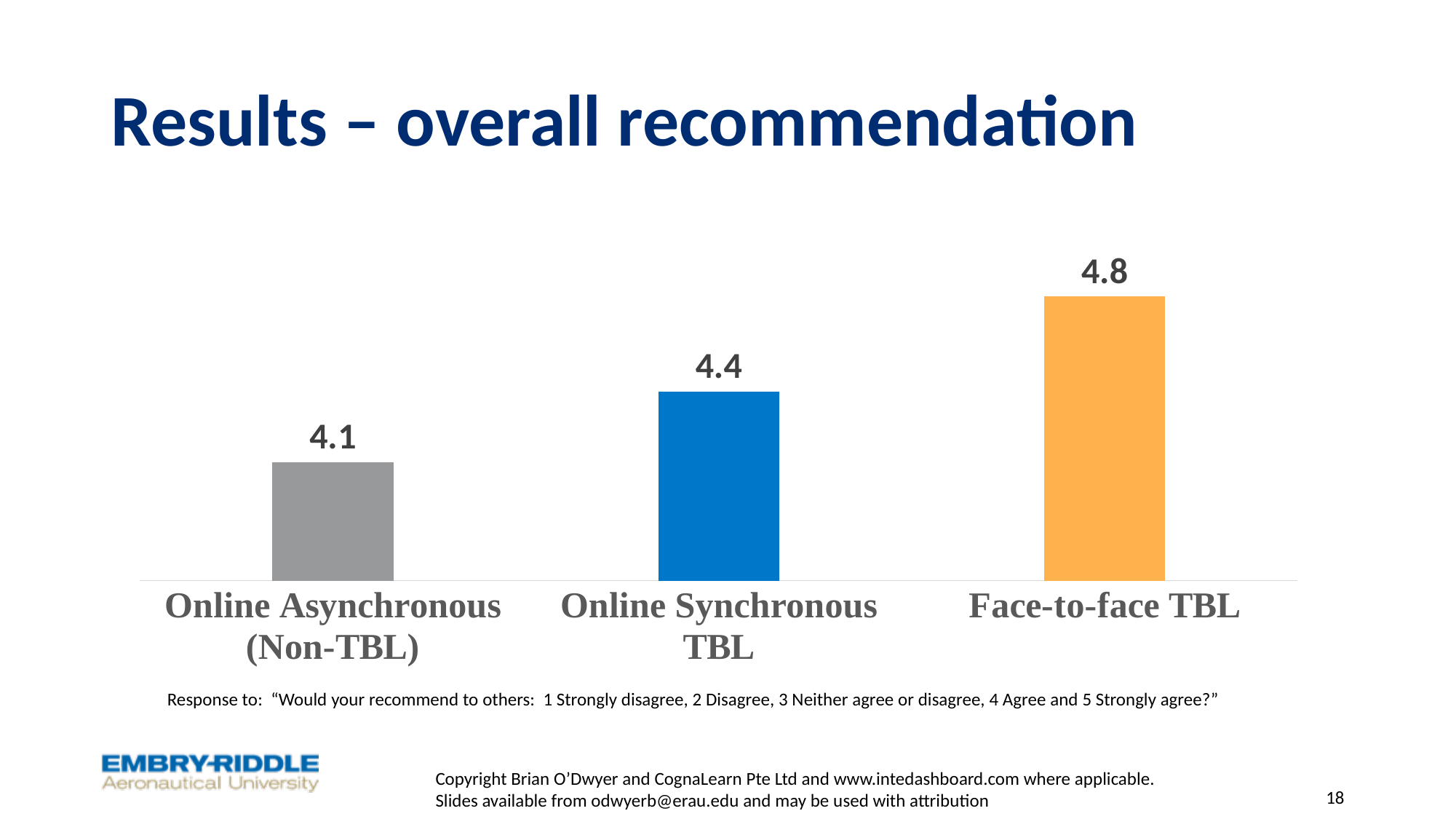
What kind of chart is shown on the slide? Bar chart Which category has the lowest value? Online Asynchronous (Non-TBL) What is the difference between the values for Face-to-face TBL and Online Asynchronous (Non-TBL)? 0.7 What colour is the bar for Face-to-face TBL? Orange Do the values rise or fall from left to right across the categories? Rise What is the value for Online Synchronous TBL? 4.4 Which category has the highest value? Face-to-face TBL Which is larger, the value for Online Synchronous TBL or Face-to-face TBL? Face-to-face TBL How many categories are shown in the chart? 3 What is the value for Online Asynchronous (Non-TBL)? 4.1 What is the difference between the values for Online Synchronous TBL and Online Asynchronous (Non-TBL)? 0.3 What is the value for Face-to-face TBL? 4.8